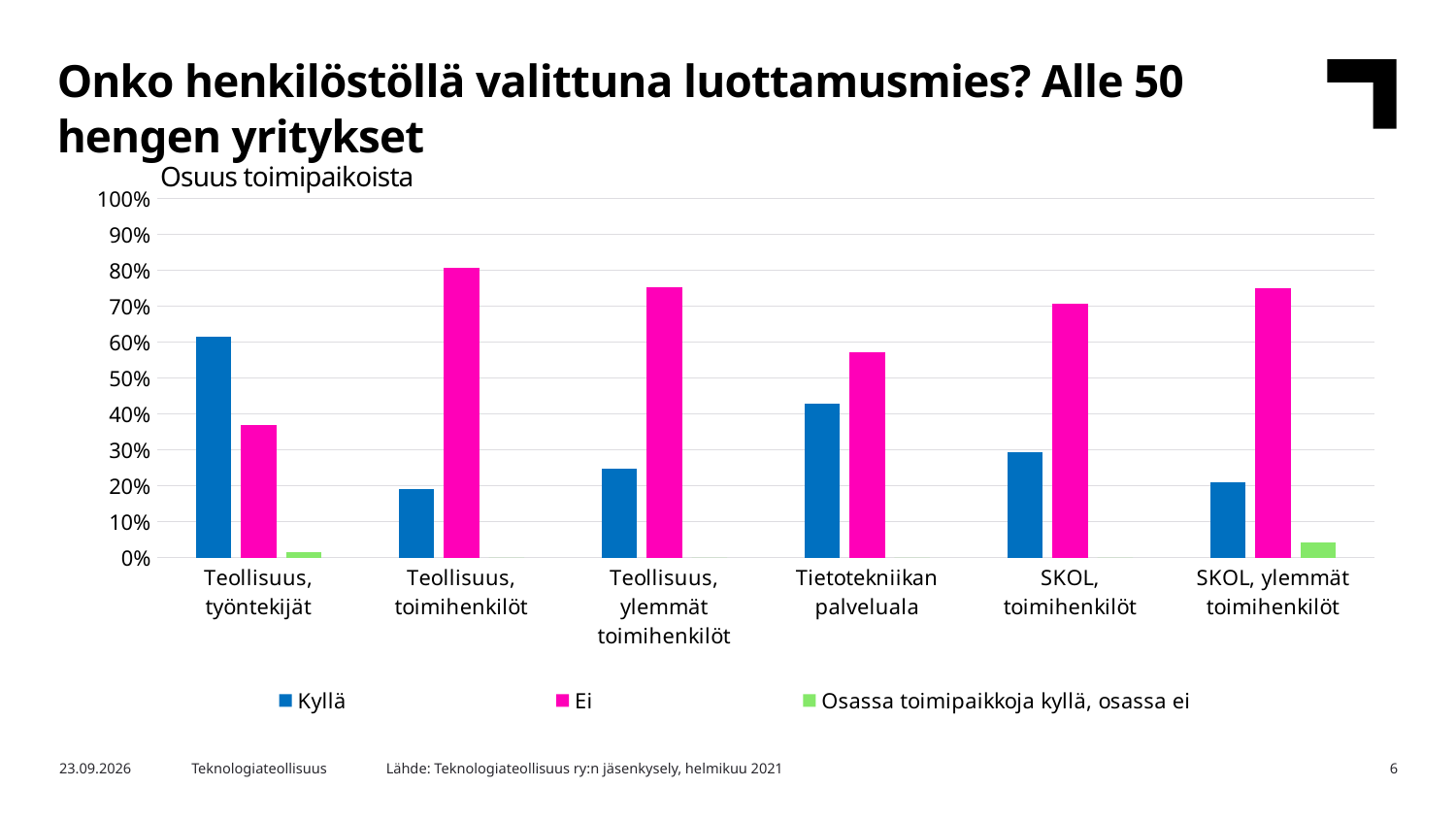
Is the Kyllä value for SKOL, ylemmät toimihenkilöt greater or less than 30%? less Is the Ei value for Teollisuus, toimihenkilöt greater or less than 70%? greater Is the Kyllä value for Teollisuus, työntekijät greater or less than 50%? greater What kind of chart is shown on the slide? bar chart For Tietotekniikan palveluala, which is larger: the Kyllä value or the Ei value? Ei Which category has the highest value for the Kyllä series? Teollisuus, työntekijät What is the title shown above the chart's y axis? Osuus toimipaikoista Which category has the lowest value for the Ei series? Teollisuus, työntekijät Which category has the highest value for the Ei series? Teollisuus, toimihenkilöt How many series does the chart's legend list? 3 How many categories are shown on the x axis of the chart? 6